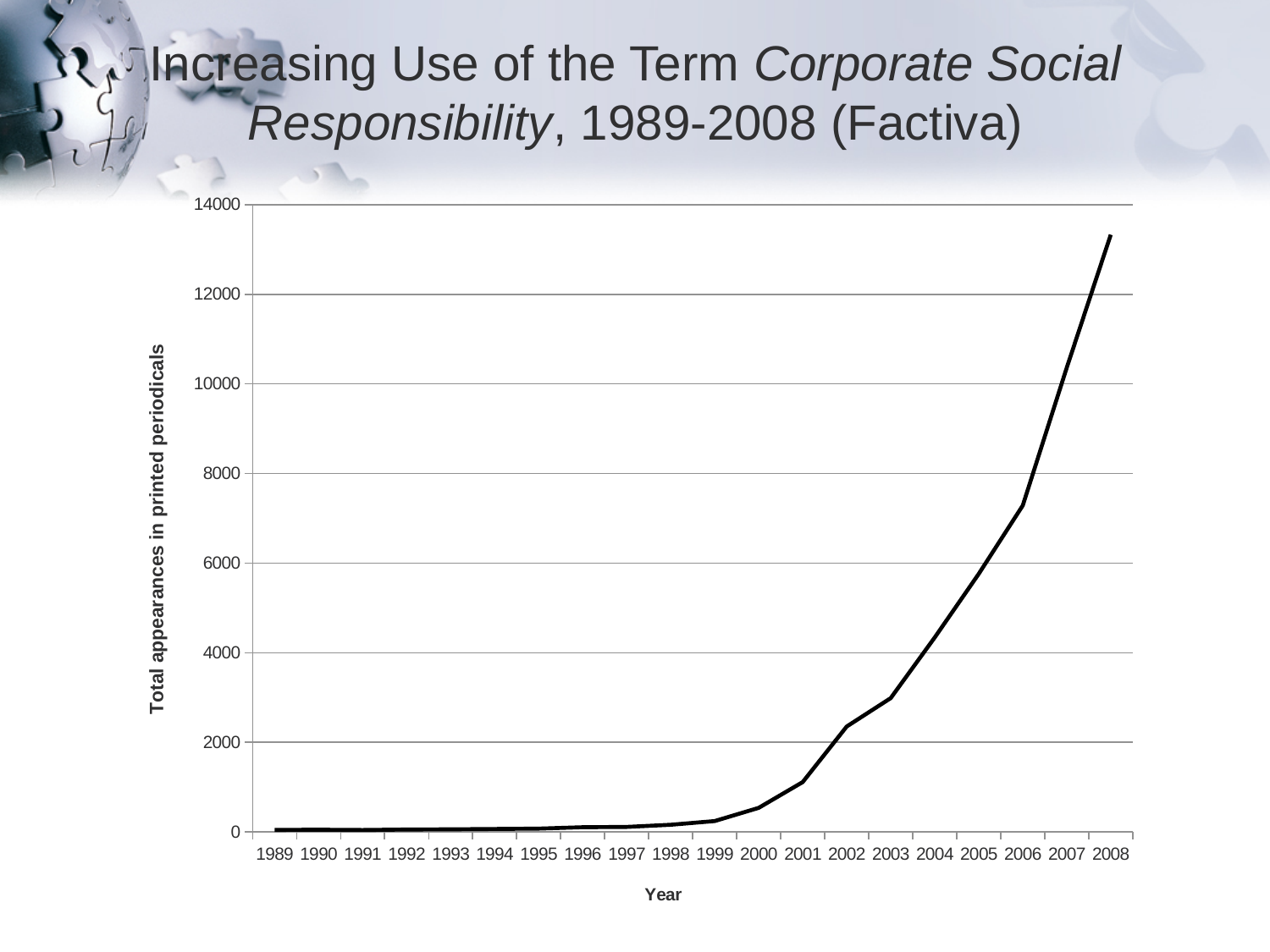
Is the value for 2006 greater or less than 8000? less Is the value for 2001 greater or less than 2000? less Which year has the highest number of total appearances in printed periodicals? 2008 What is the label on the y axis? Total appearances in printed periodicals Is the value for 2008 greater or less than 12000? greater Which year has the larger value, 2003 or 2006? 2006 What kind of chart is shown on the slide? line chart Do the values rise or fall along the x axis from 1989 to 2008? rise How many years are plotted on the x axis? 20 What is the label on the x axis? Year